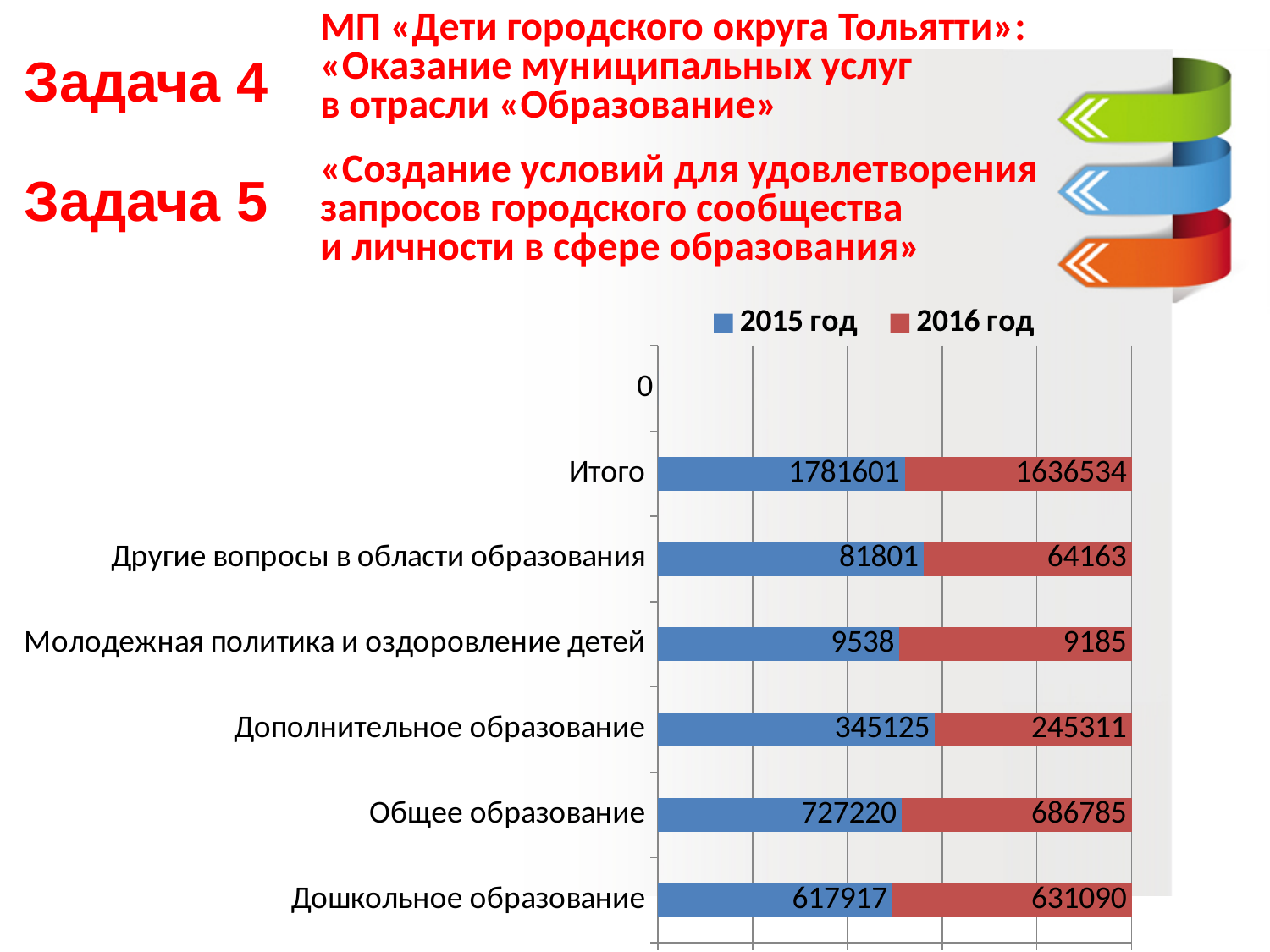
What is the 2016 год value for Другие вопросы в области образования? 64163 What is the difference between the 2015 год and 2016 год values for Итого? 145067 What is the difference between the 2015 год and 2016 год values for Дополнительное образование? 99814 What kind of chart is shown on the slide? Bar chart What is the value for Общее образование in the 2015 год series? 727220 What is the value for Дошкольное образование in the 2016 год series? 631090 What is the 2015 год value for Дополнительное образование? 345125 How many series does the legend list? 2 Excluding Итого, which category has the highest 2015 год value? Общее образование For Дошкольное образование, which series has the larger value, 2015 год or 2016 год? 2016 год What is the 2015 год value for Итого? 1781601 Which category has the lowest 2016 год value? Молодежная политика и оздоровление детей